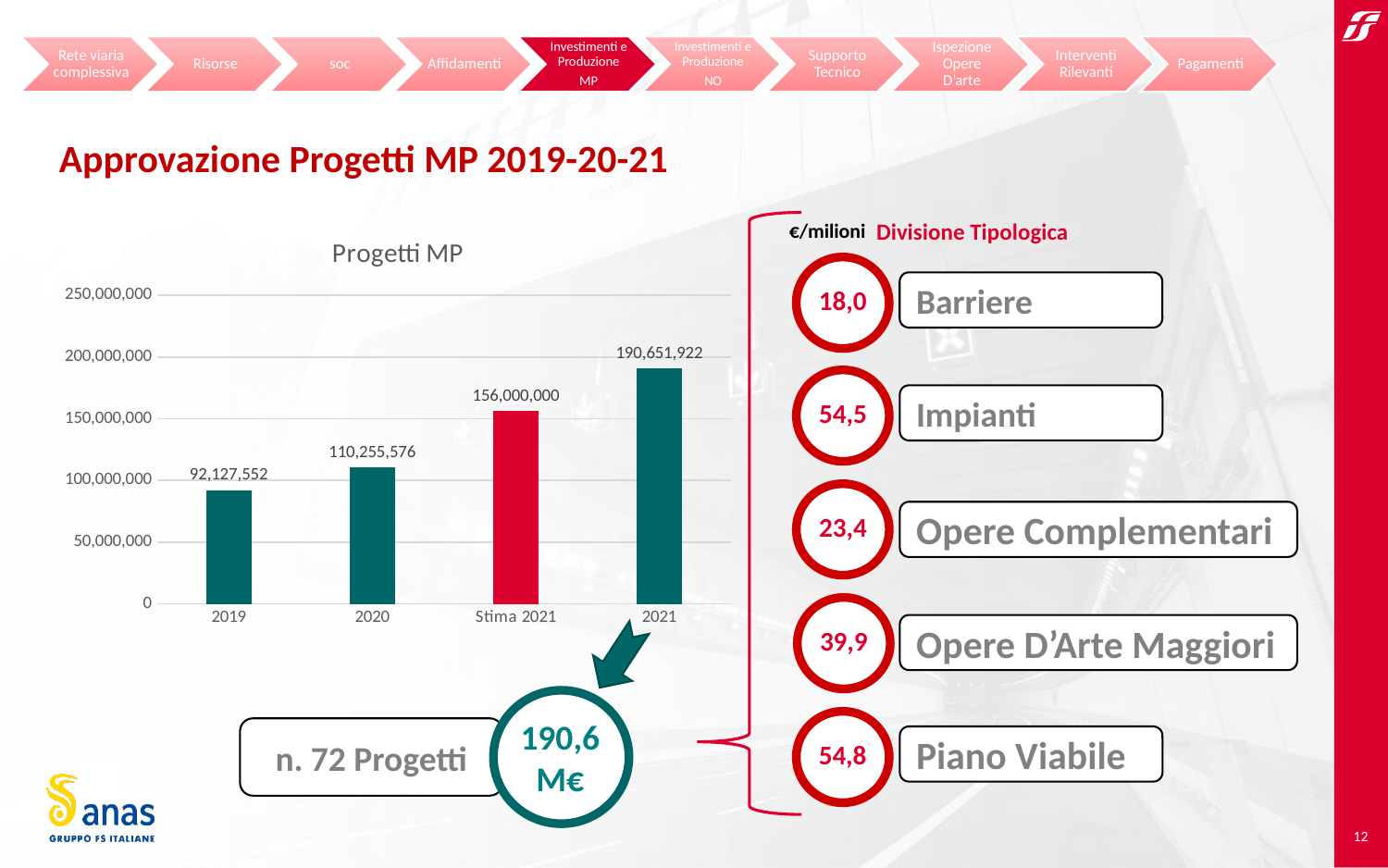
What is the difference between the 2021 value and the Stima 2021 value in the Progetti MP chart? 34,651,922 What is the value for Stima 2021 in the Progetti MP chart? 156,000,000 Which category has the lowest value in the Progetti MP chart? 2019 What is the value for 2021 in the Progetti MP chart? 190,651,922 What is the value for 2019 in the Progetti MP chart? 92,127,552 Do the values in the Progetti MP chart rise or fall from 2019 to 2021 along the x axis? rise What is the difference between the 2021 value and the 2019 value in the Progetti MP chart? 98,524,370 How many categories are shown on the x axis of the Progetti MP chart? 4 In the Progetti MP chart, which is larger: the value for 2020 or the value for Stima 2021? Stima 2021 Which category has the highest value in the Progetti MP chart? 2021 What is the value for 2020 in the Progetti MP chart? 110,255,576 What kind of chart is the Progetti MP chart? bar chart